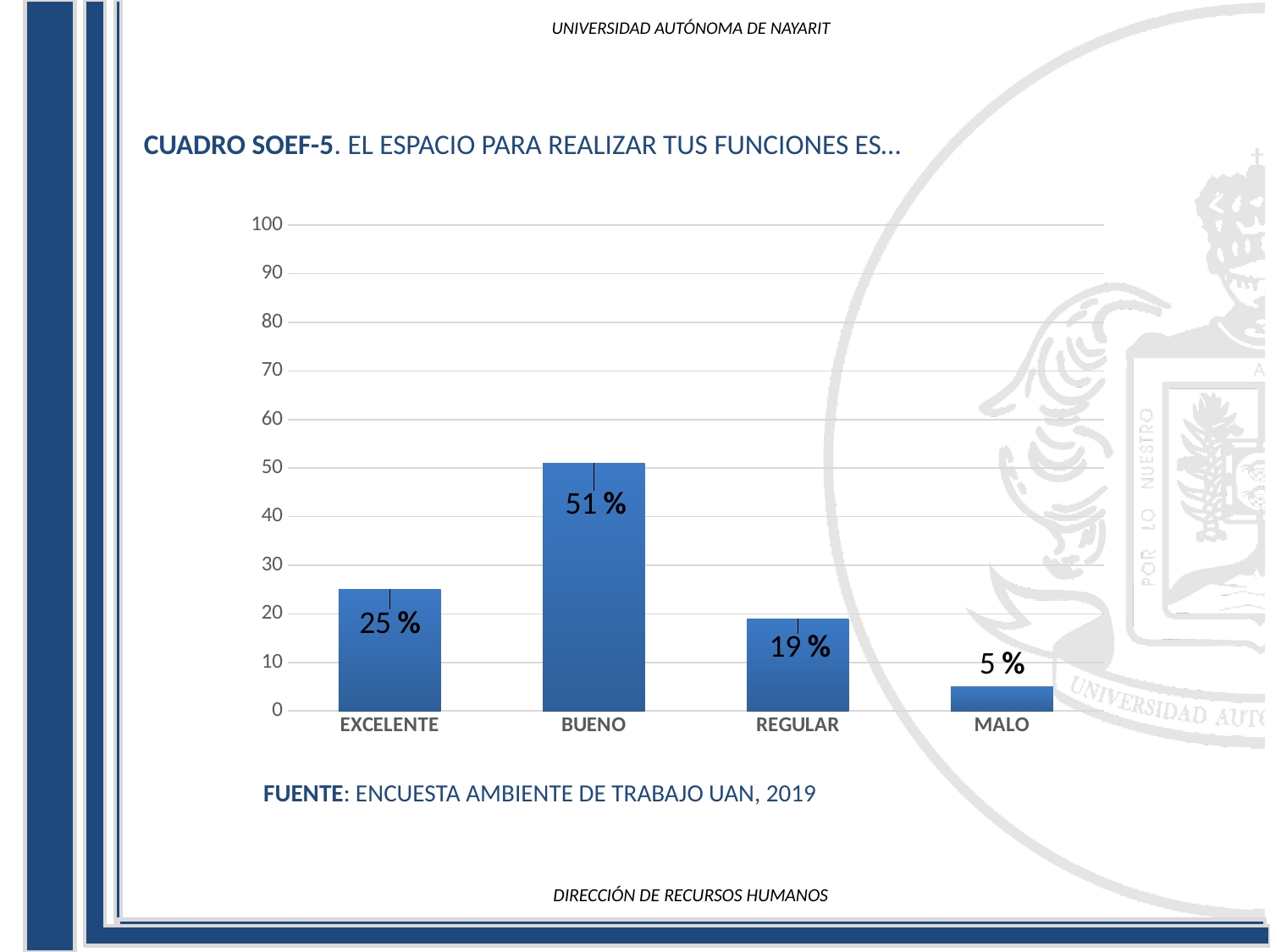
What is the value for REGULAR? 19 % Which category has the highest value? BUENO What kind of chart is shown on the slide? bar chart Is the value for BUENO greater or less than 40? greater Which is larger, the value for EXCELENTE or the value for REGULAR? EXCELENTE What is the difference between the values for BUENO and EXCELENTE? 26 % What is the value for MALO? 5 % Which category has the lowest value? MALO What is the source cited below the chart? ENCUESTA AMBIENTE DE TRABAJO UAN, 2019 How many categories are shown on the x axis? 4 What is the value for BUENO? 51 % What is the value for EXCELENTE? 25 %